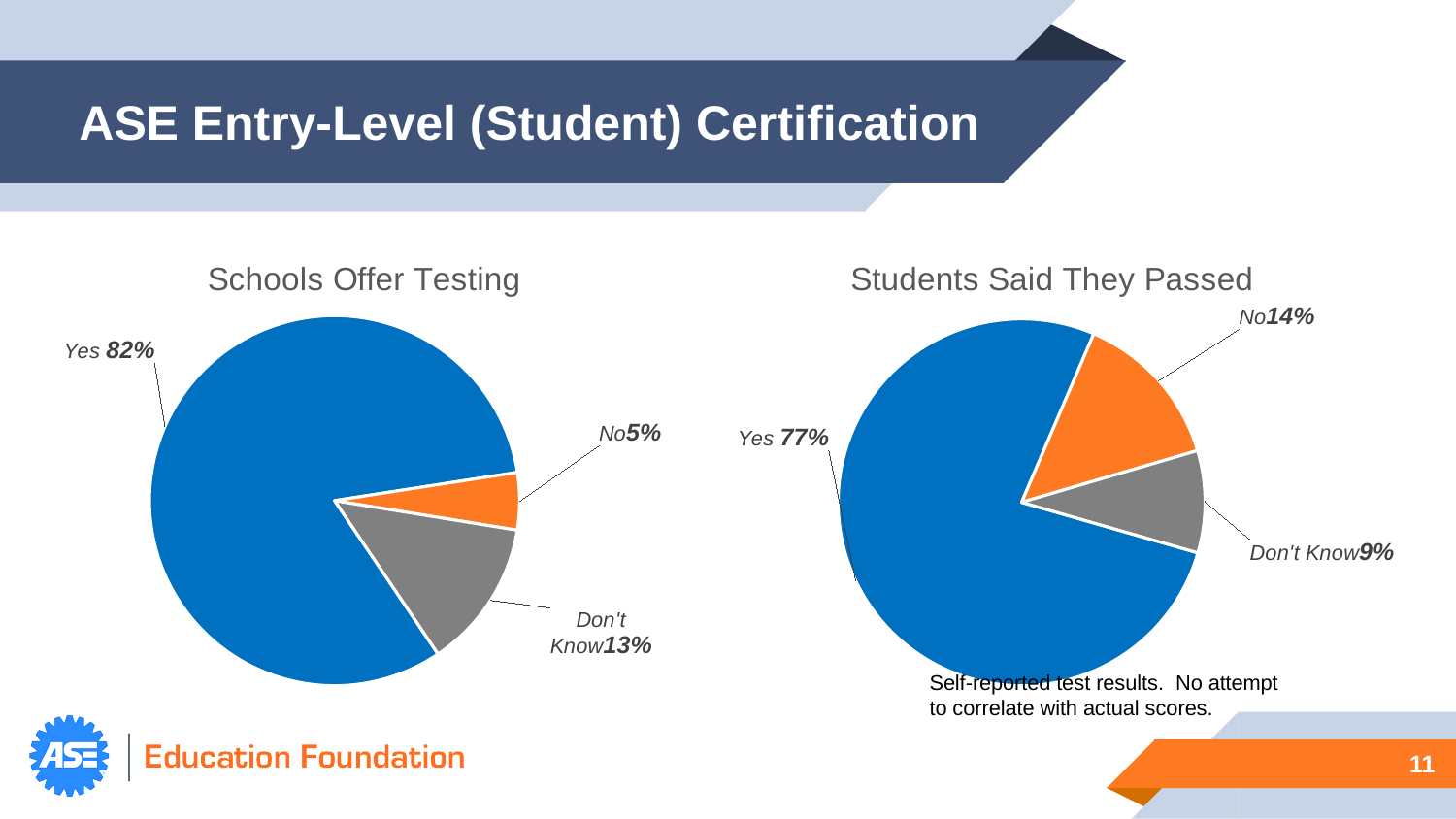
In the 'Schools Offer Testing' chart, which category has the smallest slice? No Which is larger in the 'Schools Offer Testing' chart: the Don't Know slice or the No slice? Don't Know In the 'Students Said They Passed' chart, what percentage answered Don't Know? 9% In the 'Students Said They Passed' chart, what is the difference between the No and Don't Know percentages? 5% What type of chart is 'Students Said They Passed'? Pie chart In the 'Students Said They Passed' chart, what percentage answered Yes? 77% How many slices does the 'Schools Offer Testing' pie chart have? 3 In the 'Schools Offer Testing' chart, what percentage answered Don't Know? 13% In the 'Students Said They Passed' chart, which category has the largest slice? Yes In the 'Students Said They Passed' chart, what percentage answered No? 14% In the 'Schools Offer Testing' chart, what percentage answered Yes? 82% In the 'Schools Offer Testing' chart, what percentage answered No? 5%